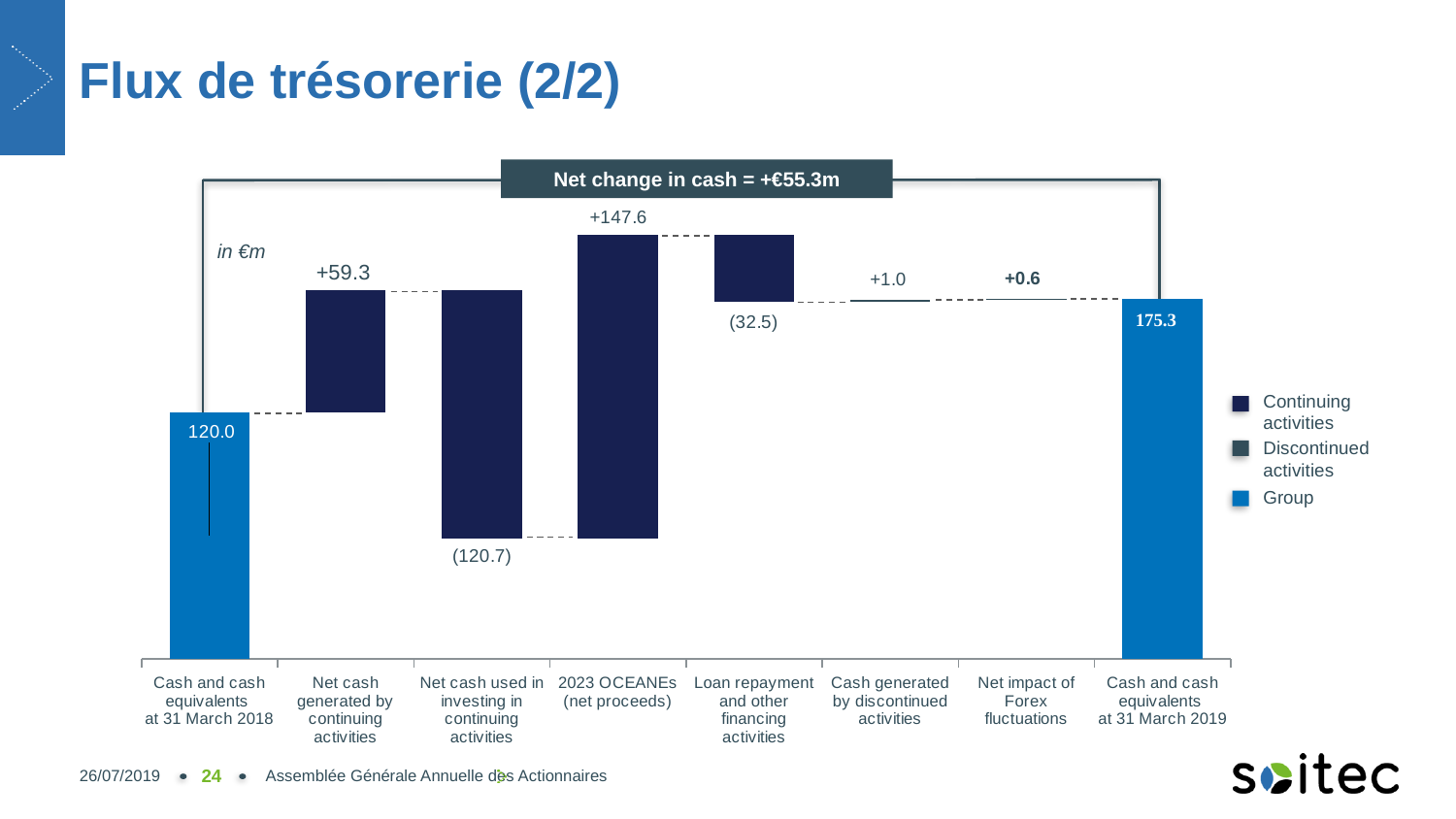
What is the value shown for Net impact of Forex fluctuations? +0.6 Which is larger: the value for Net cash generated by continuing activities or the value for Cash generated by discontinued activities? Net cash generated by continuing activities What is the value shown for 2023 OCEANEs (net proceeds)? +147.6 What net change in cash is stated in the box above the chart? +€55.3m What is the value shown for Net cash used in investing in continuing activities? (120.7) What is the difference between Cash and cash equivalents at 31 March 2019 and at 31 March 2018? 55.3 What is the value shown for Cash and cash equivalents at 31 March 2018? 120.0 How many entries does the legend list? 3 Which category has the largest positive value in the chart? 2023 OCEANEs (net proceeds) What is the value shown for Loan repayment and other financing activities? (32.5) What is the value shown for Cash and cash equivalents at 31 March 2019? 175.3 What is the value shown for Net cash generated by continuing activities? +59.3